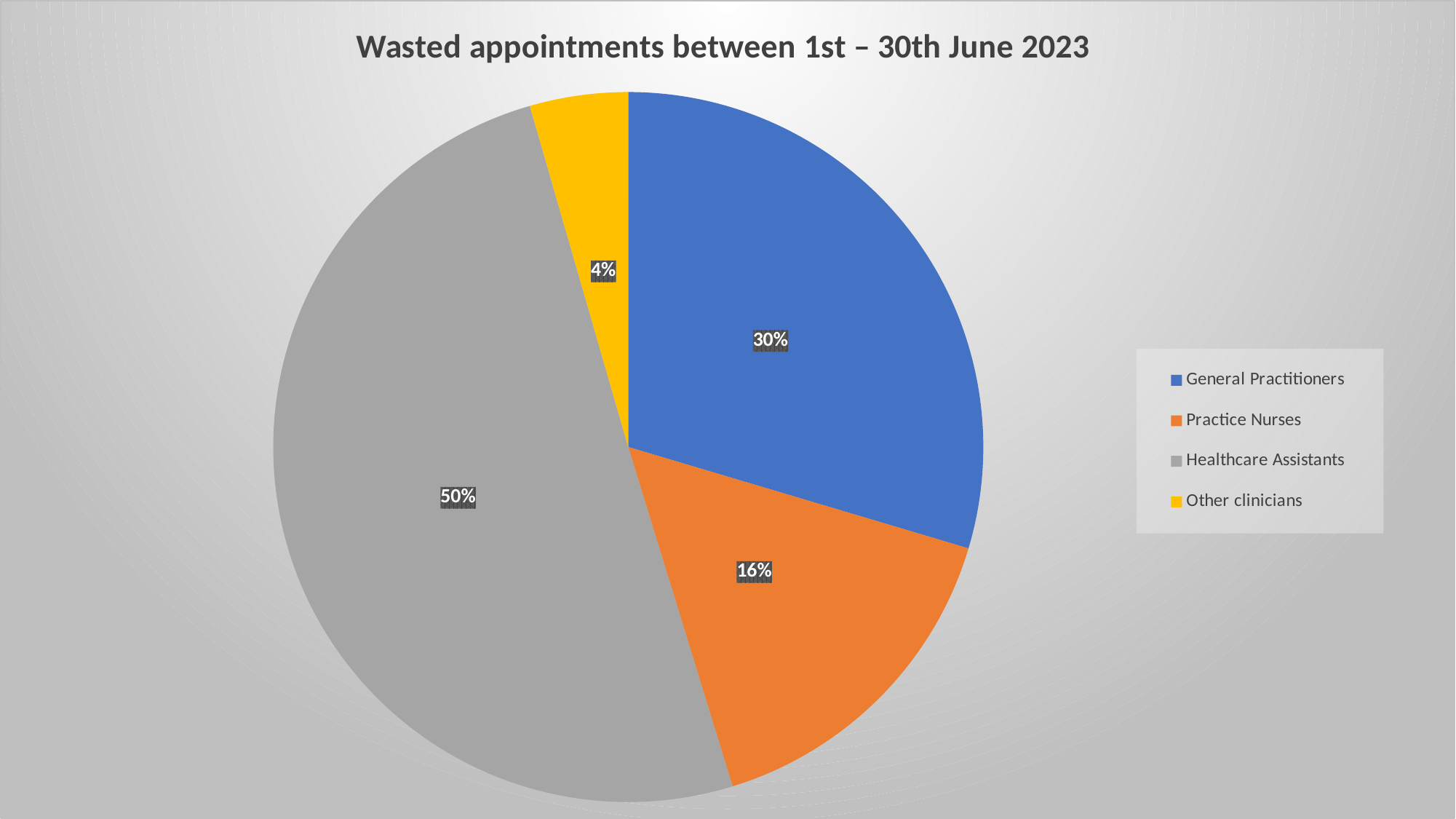
What is the difference in percentage points between the Healthcare Assistants share and the General Practitioners share? 20 percentage points What kind of chart is shown on the slide? Pie chart Which has a larger share of wasted appointments, Practice Nurses or General Practitioners? General Practitioners Which colour represents Other clinicians in the chart? Yellow Which category accounts for the smallest share of wasted appointments? Other clinicians Which category accounts for the largest share of wasted appointments? Healthcare Assistants What share of wasted appointments is attributed to General Practitioners? 30% What share of wasted appointments is attributed to Other clinicians? 4% What share of wasted appointments is attributed to Practice Nurses? 16% How many categories are shown in the pie chart? 4 What is the title of the chart? Wasted appointments between 1st – 30th June 2023 What share of wasted appointments is attributed to Healthcare Assistants? 50%